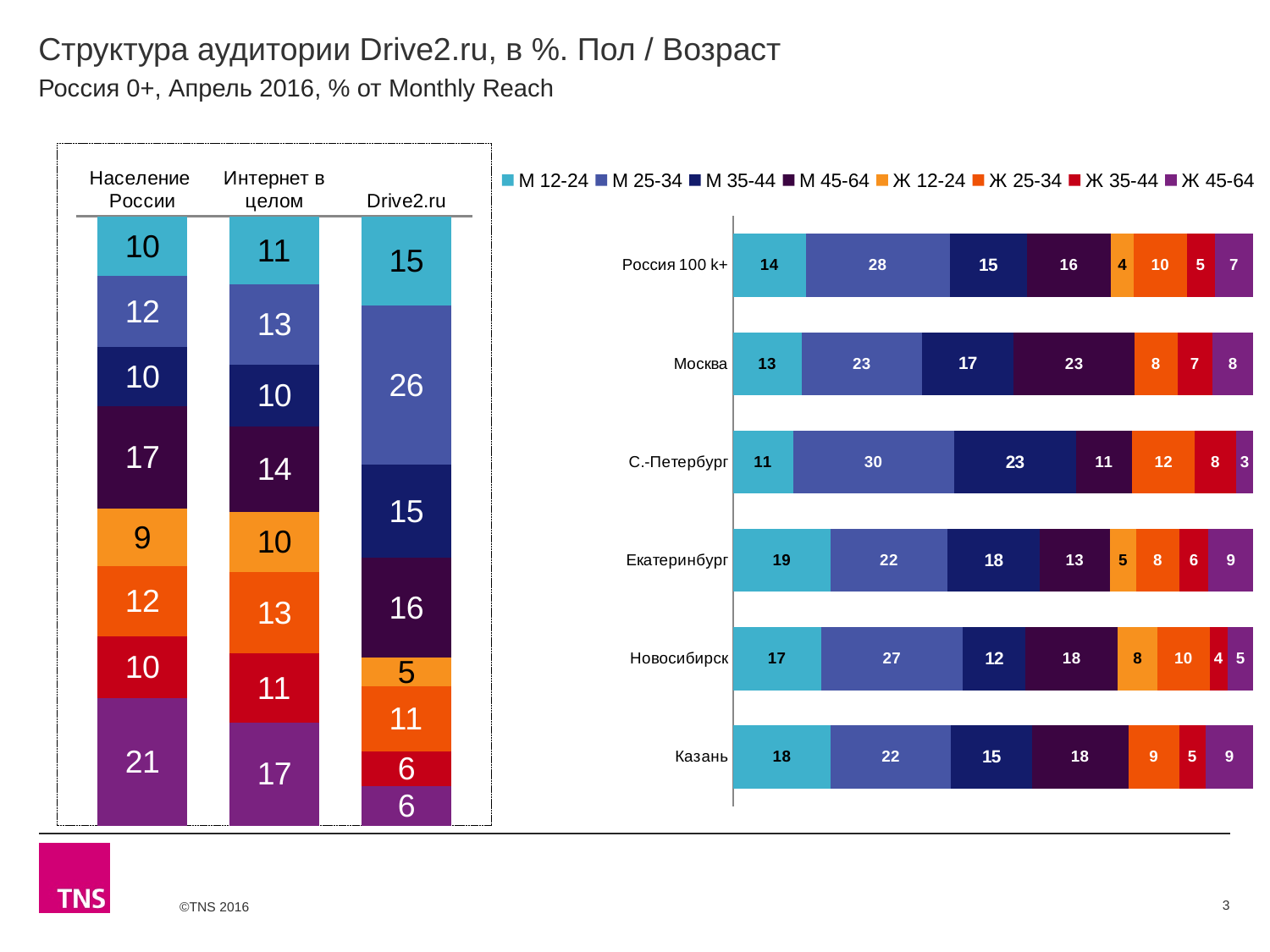
In the left chart, what is the value of the largest segment (М 25-34, blue) in the Drive2.ru bar? 26 What kind of chart is the right chart? Stacked horizontal bar chart How many cities/regions are shown on the right chart? 6 In the right chart, what is the value for М 25-34 in С.-Петербург? 30 In the right chart, what is the difference between the М 45-64 values for Москва and Россия 100 k+? 7 In the right chart, which city has the lowest value for М 12-24? С.-Петербург How many series does the legend of the right chart list? 8 In the right chart, which is larger: М 35-44 in Москва or М 35-44 in Казань? Москва In the right chart, which city has the highest value for М 25-34? С.-Петербург In the left chart, what is the value of the bottom segment (Ж 45-64, purple) in the Население России bar? 21 In the right chart, what is the value for М 12-24 in Екатеринбург? 19 In the right chart, what is the value for Ж 25-34 in Новосибирск? 10